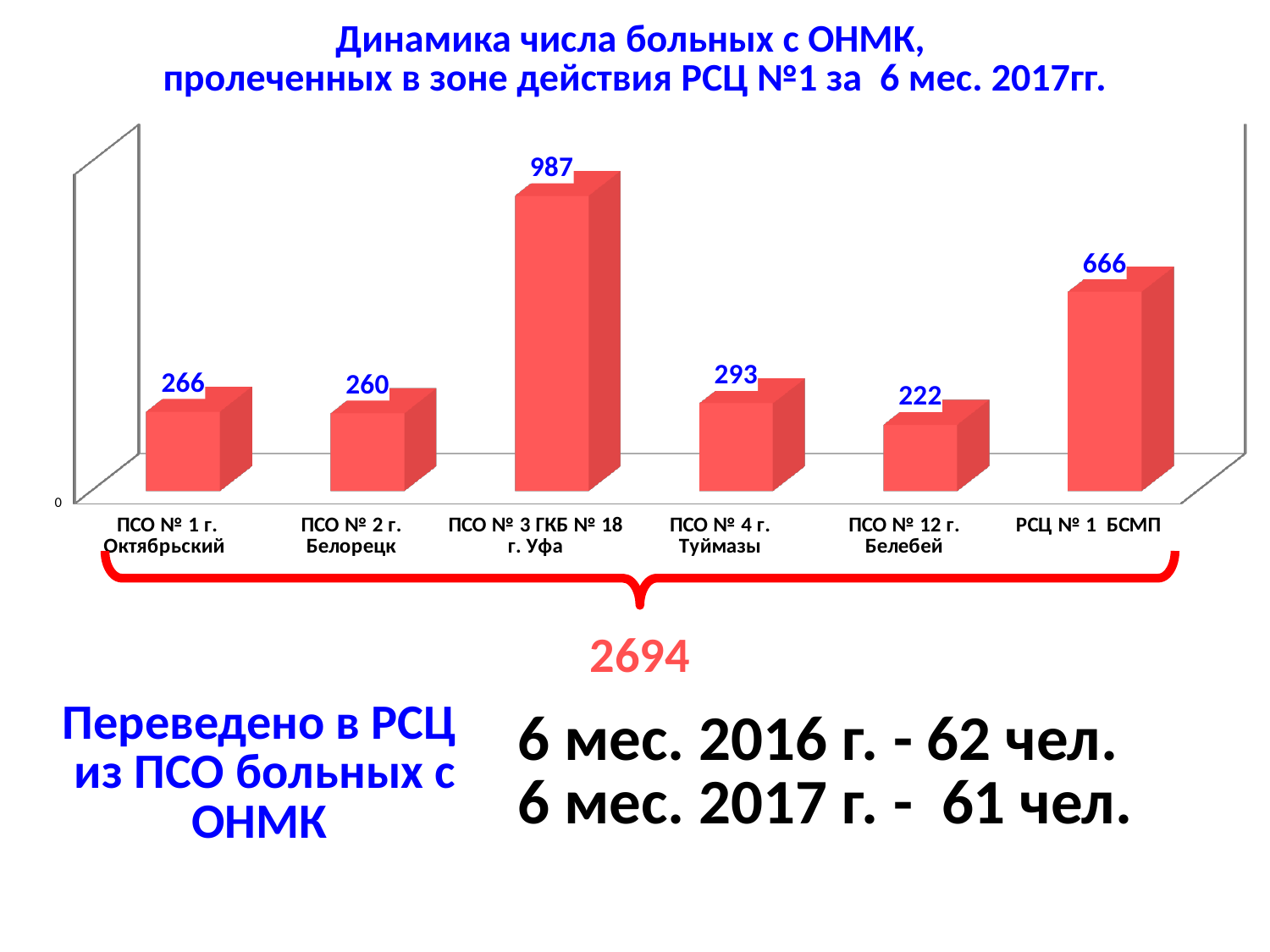
What is the difference between the values for ПСО № 3 ГКБ № 18 г. Уфа and РСЦ № 1 БСМП? 321 How many categories are shown in the chart? 6 What is the value for ПСО № 3 ГКБ № 18 г. Уфа? 987 What is the value for РСЦ № 1 БСМП? 666 What is the difference between the values for ПСО № 1 г. Октябрьский and ПСО № 2 г. Белорецк? 6 What is the value for ПСО № 12 г. Белебей? 222 What is the value for ПСО № 4 г. Туймазы? 293 Which category has the highest value? ПСО № 3 ГКБ № 18 г. Уфа What kind of chart is shown on the slide? bar chart Which category has the lowest value? ПСО № 12 г. Белебей What total is shown under the bracket beneath the chart? 2694 Which is larger, the value for ПСО № 4 г. Туймазы or ПСО № 12 г. Белебей? ПСО № 4 г. Туймазы